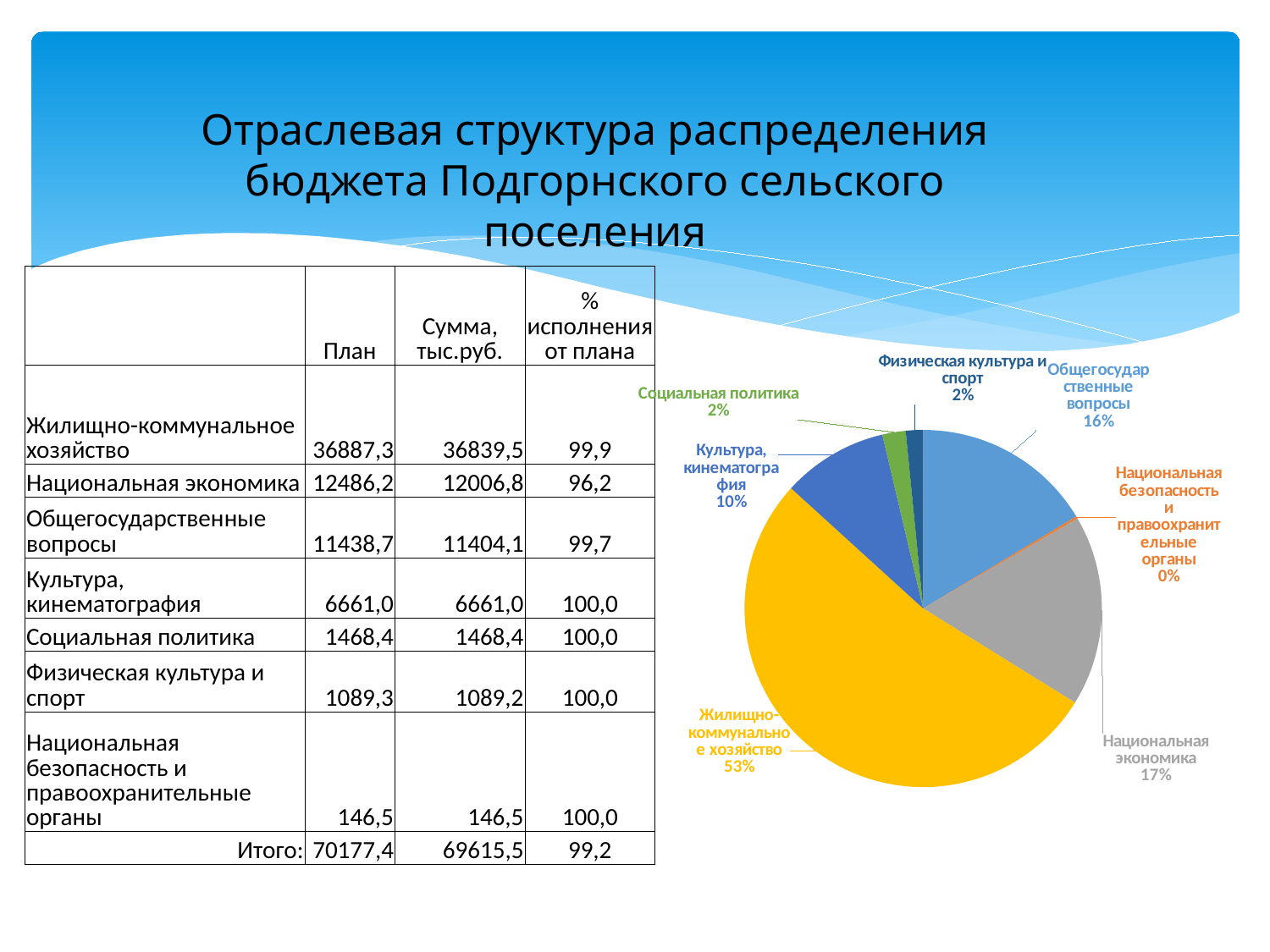
What share of the pie does Жилищно-коммунальное хозяйство have? 53% What share of the pie does Социальная политика have? 2% How many slices does the pie chart have? 7 Which category has the largest slice of the pie? Жилищно-коммунальное хозяйство What share of the pie does Национальная экономика have? 17% Which category has the smallest slice of the pie? Национальная безопасность и правоохранительные органы Which has a larger share of the pie, Национальная экономика or Общегосударственные вопросы? Национальная экономика By how many percentage points does the share of Жилищно-коммунальное хозяйство exceed that of Национальная экономика? 36 What kind of chart is shown on the slide? pie chart